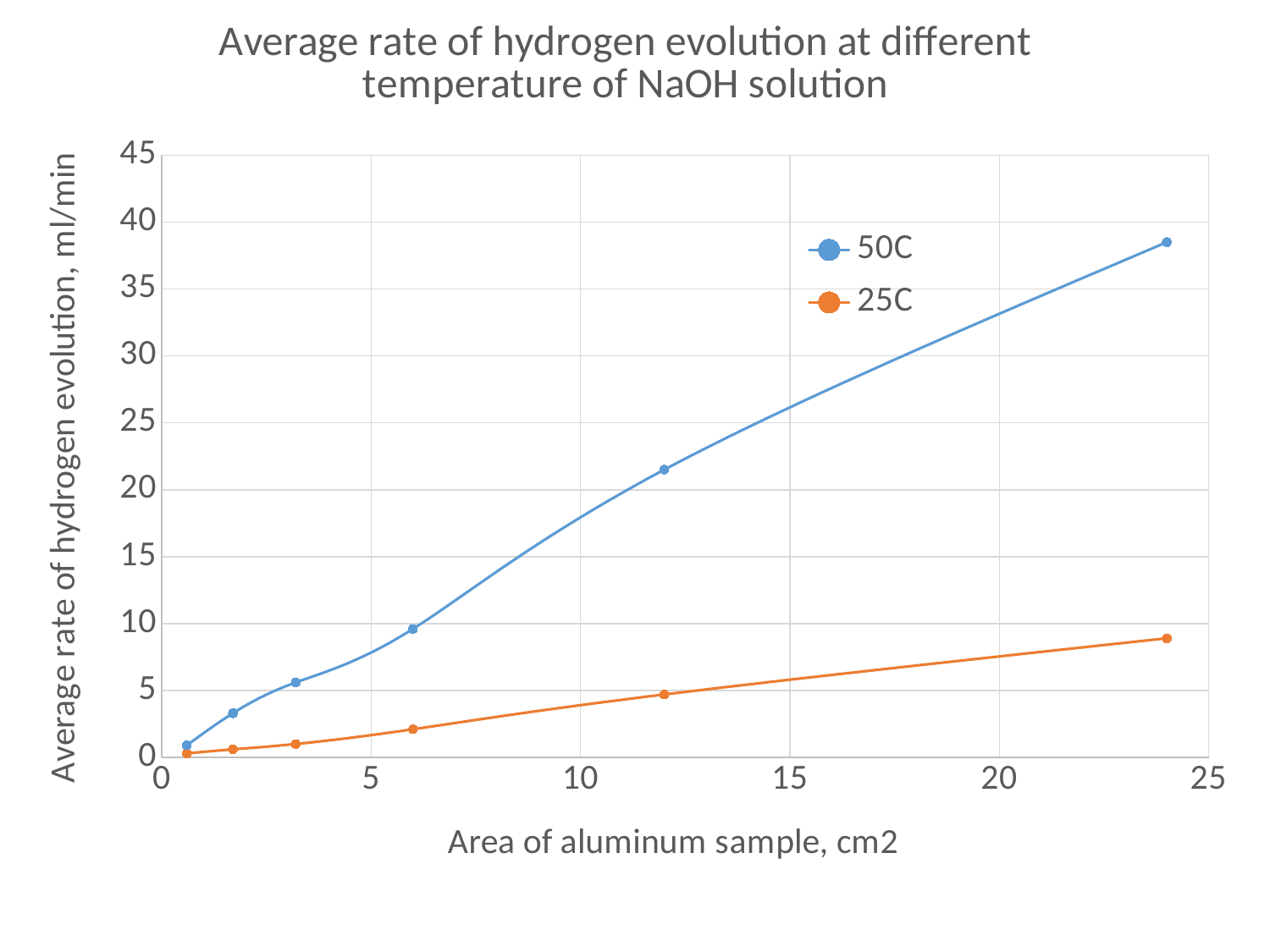
Which series has the higher rate of hydrogen evolution at a sample area of about 24 cm2, 50C or 25C? 50C Is the value for the 25C series at the largest sample area (about 24 cm2) greater or less than 10? less What kind of chart is shown on the slide? line chart Do the values for the 25C series rise or fall as the area of the aluminum sample increases? rise Is the value for the 25C series at a sample area of about 12 cm2 greater or less than 10? less What is the label of the x axis? Area of aluminum sample, cm2 Is the value for the 50C series at a sample area of about 12 cm2 greater or less than 20? greater How many data points are plotted for the 50C series? 6 Which series reaches the highest rate of hydrogen evolution on the chart? 50C Do the values for the 50C series rise or fall as the area of the aluminum sample increases? rise How many series does the legend list? 2